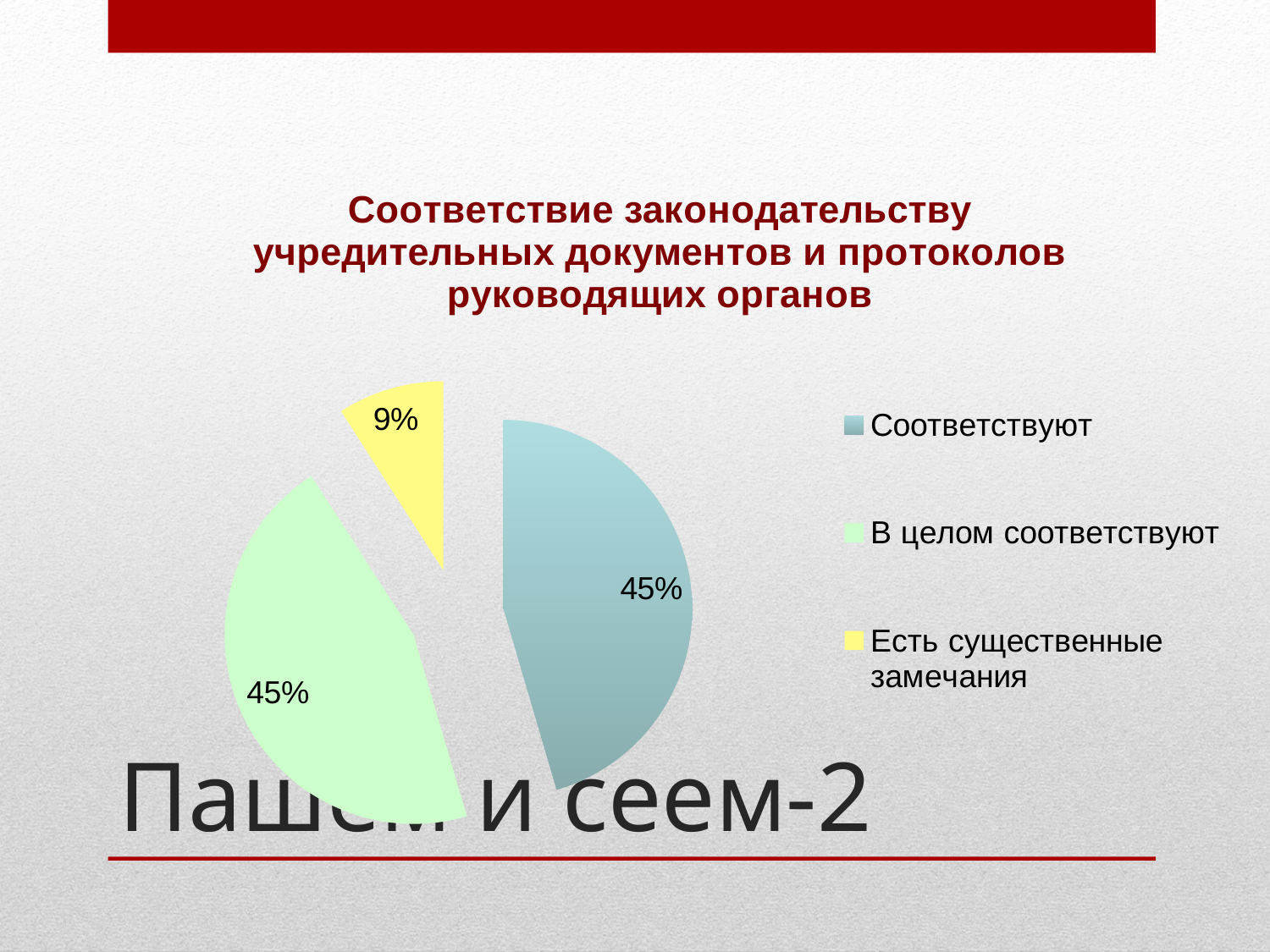
What is the difference between the values for "Соответствуют" and "Есть существенные замечания"? 36% What kind of chart is shown on the slide? pie chart How many entries does the legend list? 3 What is the title of the chart? Соответствие законодательству учредительных документов и протоколов руководящих органов Which category has the smallest slice? Есть существенные замечания What colour is the slice for "Есть существенные замечания"? yellow What is the value for "Есть существенные замечания"? 9% How many slices does the pie chart have? 3 What is the value for "В целом соответствуют"? 45% What is the value for "Соответствуют"? 45% Which is larger, the value for "В целом соответствуют" or the value for "Есть существенные замечания"? В целом соответствуют